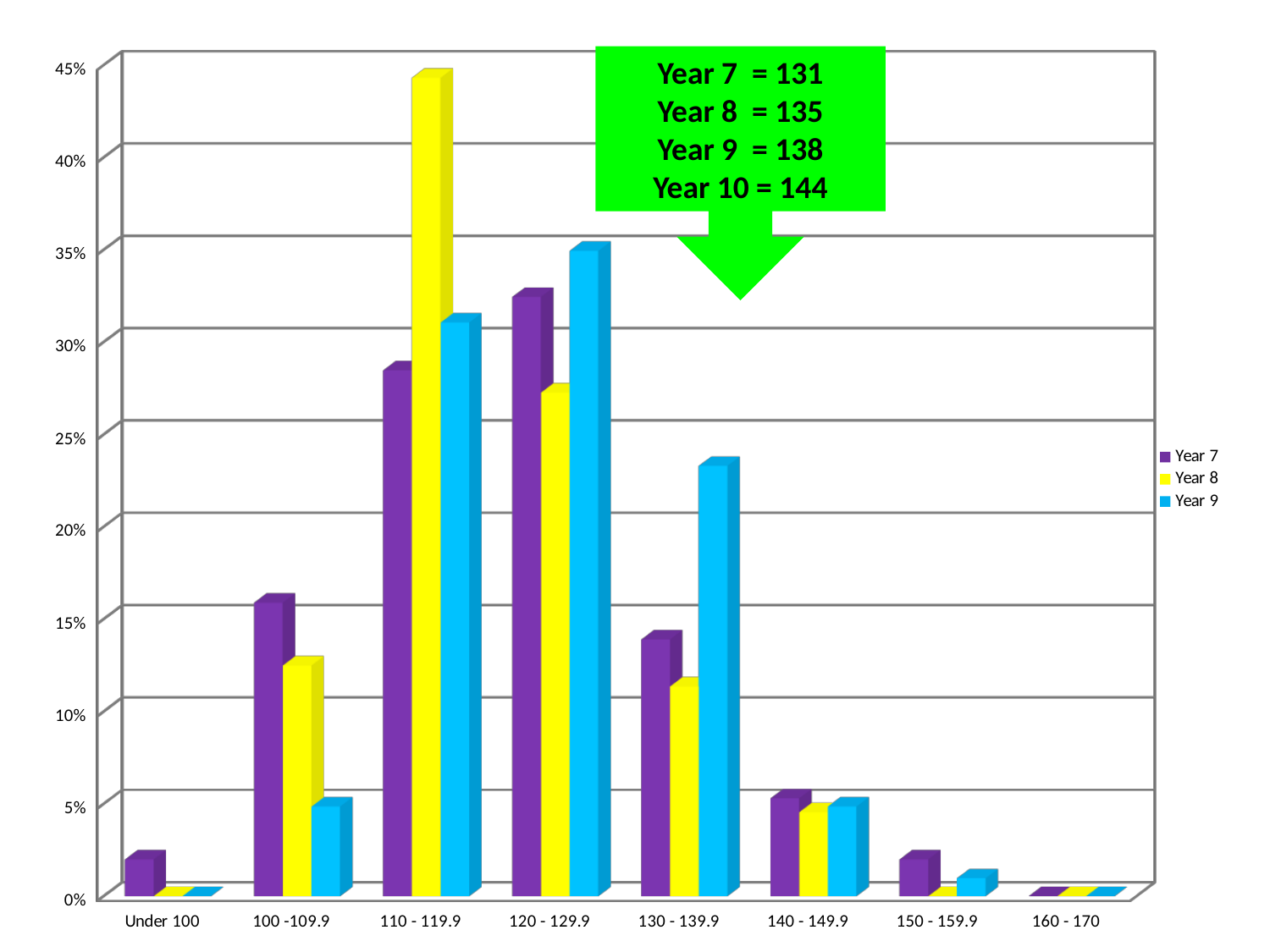
Is the Year 9 value for 120 - 129.9 greater or less than 30%? greater What kind of chart is shown on the slide? bar chart Is the Year 8 value for 110 - 119.9 greater or less than 40%? greater In the 130 - 139.9 category, which is larger: Year 8 or Year 9? Year 9 How many series does the legend list? 3 For Year 8, which category has the highest value? 110 - 119.9 For Year 9, which category has the highest value? 120 - 129.9 How many categories are shown along the x axis? 8 In the 100 -109.9 category, which is larger: Year 7 or Year 9? Year 7 For Year 7, which category has the highest value? 120 - 129.9 According to the green callout box, what is the value given for Year 10? 144 Is the Year 9 value for 130 - 139.9 greater or less than 20%? greater